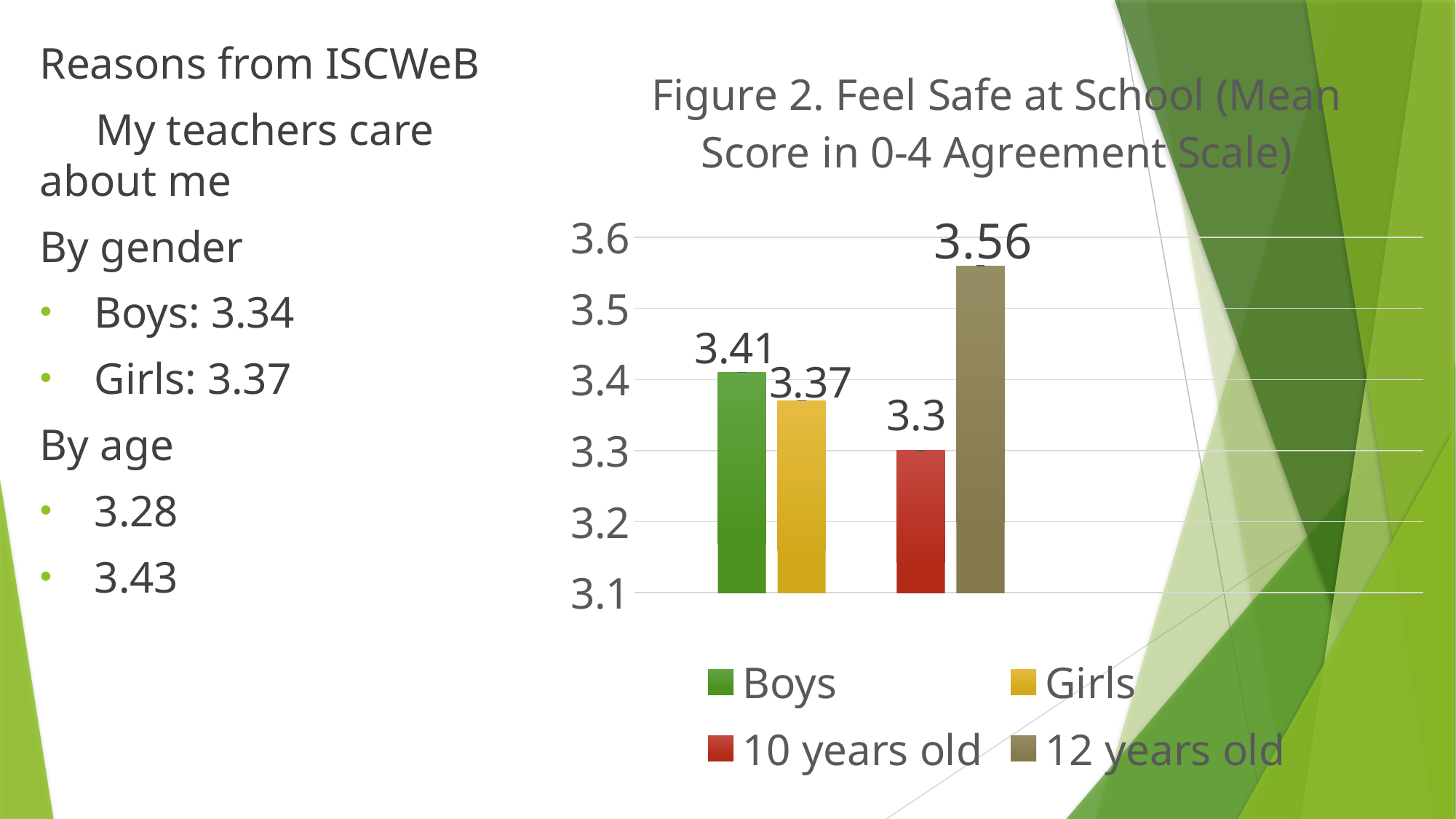
What is the difference between the mean scores for 12 years old and 10 years old? 0.26 What is the mean score for 12 years old in the Feel Safe at School chart? 3.56 What is the mean score for 10 years old in the Feel Safe at School chart? 3.3 How many series does the legend list in the Feel Safe at School chart? 4 What is the title of the chart on the slide? Figure 2. Feel Safe at School (Mean Score in 0-4 Agreement Scale) Which group has the highest mean score in the Feel Safe at School chart? 12 years old What kind of chart is Figure 2? Bar chart What is the mean score for Boys in the Feel Safe at School chart? 3.41 Which group has the lowest mean score in the Feel Safe at School chart? 10 years old What is the mean score for Girls in the Feel Safe at School chart? 3.37 Which has a higher mean score, Boys or Girls? Boys What is the difference between the mean scores for Boys and Girls? 0.04